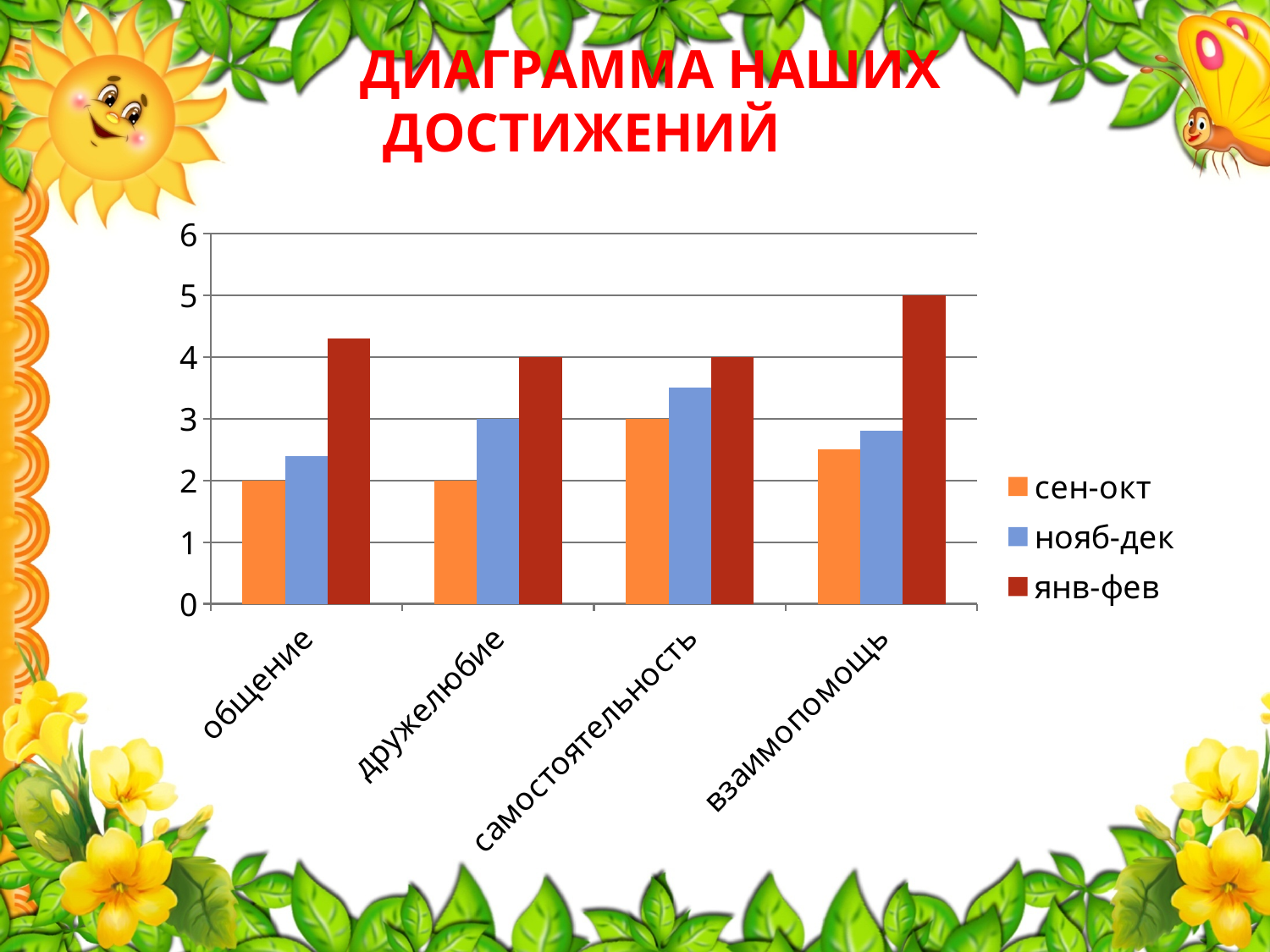
How many categories are shown on the x axis? 4 What is the value for взаимопомощь in the янв-фев series? 5 What is the value for дружелюбие in the нояб-дек series? 3 For дружелюбие, which series has the larger value: сен-окт or янв-фев? янв-фев How many series does the legend list? 3 What is the difference between the янв-фев and сен-окт values for дружелюбие? 2 Is the value for самостоятельность in the нояб-дек series greater or less than 3? greater Is the value for общение in the янв-фев series greater or less than 4? greater What kind of chart is shown on the slide? bar chart Which category has the highest value in the сен-окт series? самостоятельность What is the value for общение in the сен-окт series? 2 Which category has the highest value in the янв-фев series? взаимопомощь